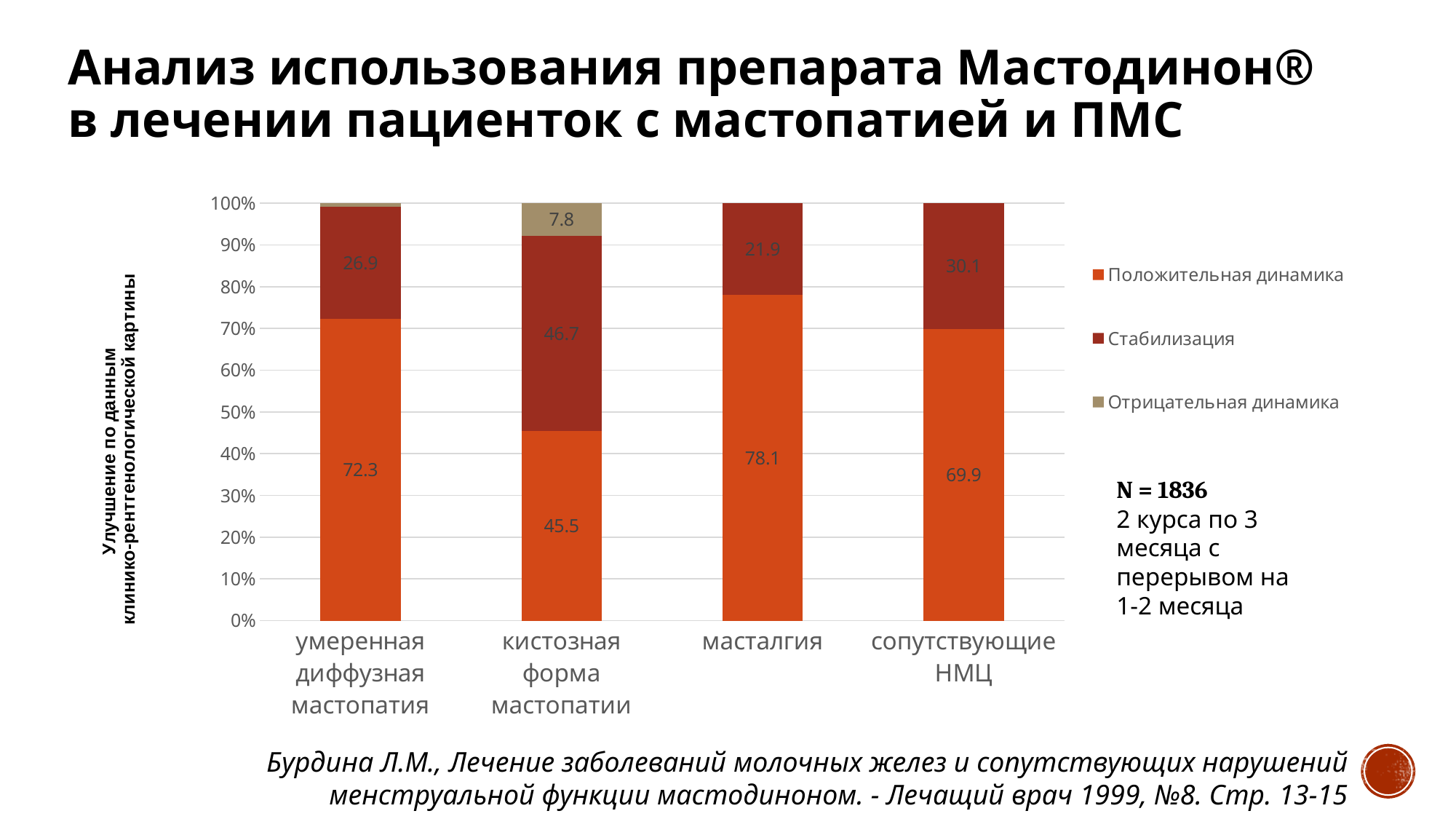
How many series does the legend list? 3 What is the sample size (N) stated next to the chart? N = 1836 Which category has the lowest value for Положительная динамика? кистозная форма мастопатии Which is larger: Стабилизация for умеренная диффузная мастопатия or Стабилизация for масталгия? умеренная диффузная мастопатия How many categories are shown on the x axis? 4 What is the difference between the Положительная динамика values for масталгия and умеренная диффузная мастопатия? 5.8 What is the value of Положительная динамика for масталгия? 78.1 What is the value of Стабилизация for сопутствующие НМЦ? 30.1 Which category has the highest value for Положительная динамика? масталгия What is the value of Стабилизация for кистозная форма мастопатии? 46.7 What kind of chart is shown on the slide? stacked bar chart What is the value of Отрицательная динамика for кистозная форма мастопатии? 7.8